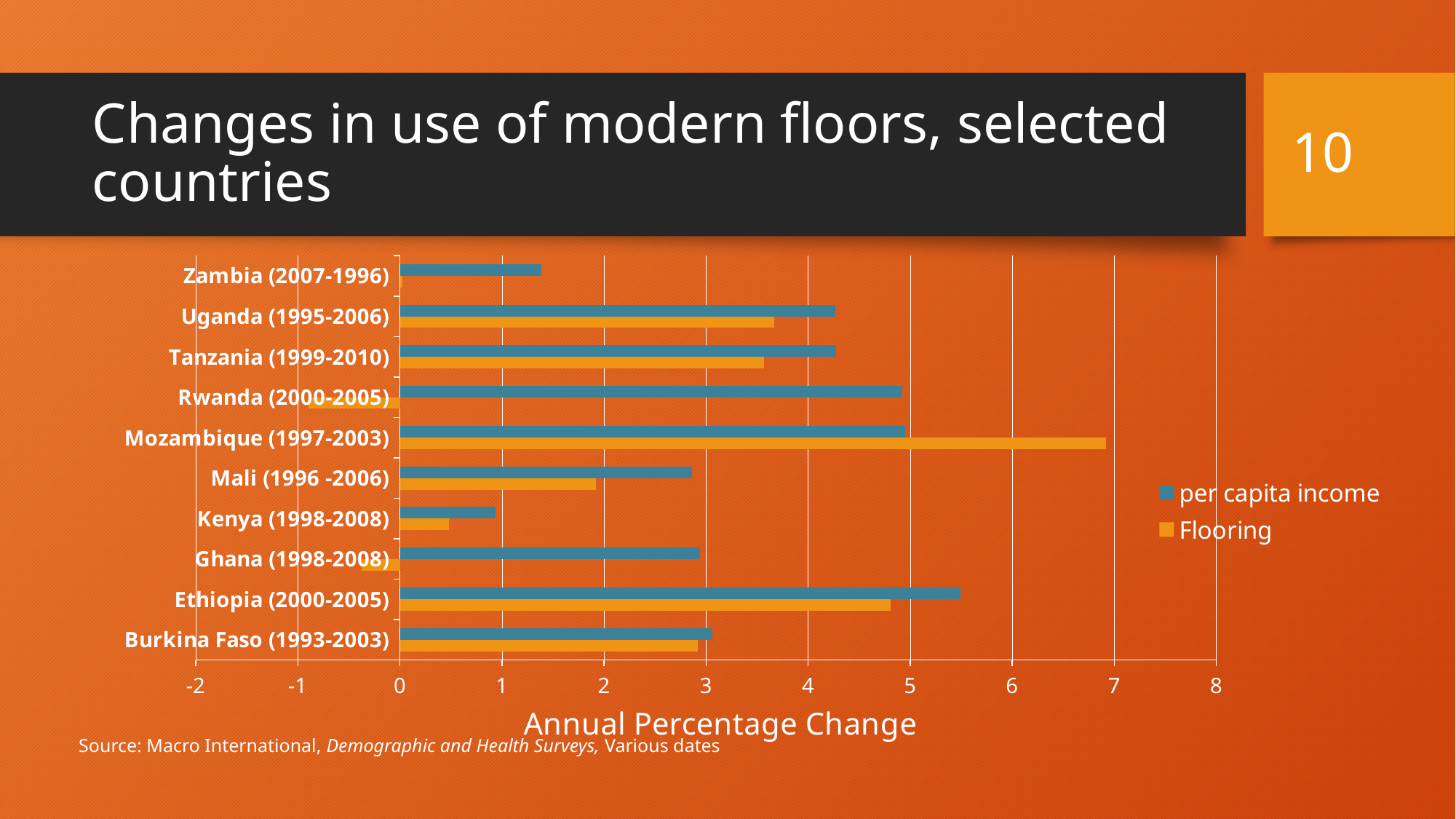
Which country has the lowest per capita income value? Kenya (1998-2008) How many countries are listed on the chart? 10 Is the per capita income value for Zambia (2007-1996) greater or less than 2? less For Mozambique (1997-2003), which is larger: per capita income or Flooring? Flooring Which country has the lowest Flooring value? Rwanda (2000-2005) What is the title of the horizontal axis? Annual Percentage Change How many series does the legend list? 2 Is the Flooring value for Mozambique (1997-2003) greater or less than 6? greater Is the Flooring value for Rwanda (2000-2005) greater or less than 0? less What kind of chart is shown on the slide? bar chart Which country has the highest per capita income value? Ethiopia (2000-2005) Which country has the highest Flooring value? Mozambique (1997-2003)